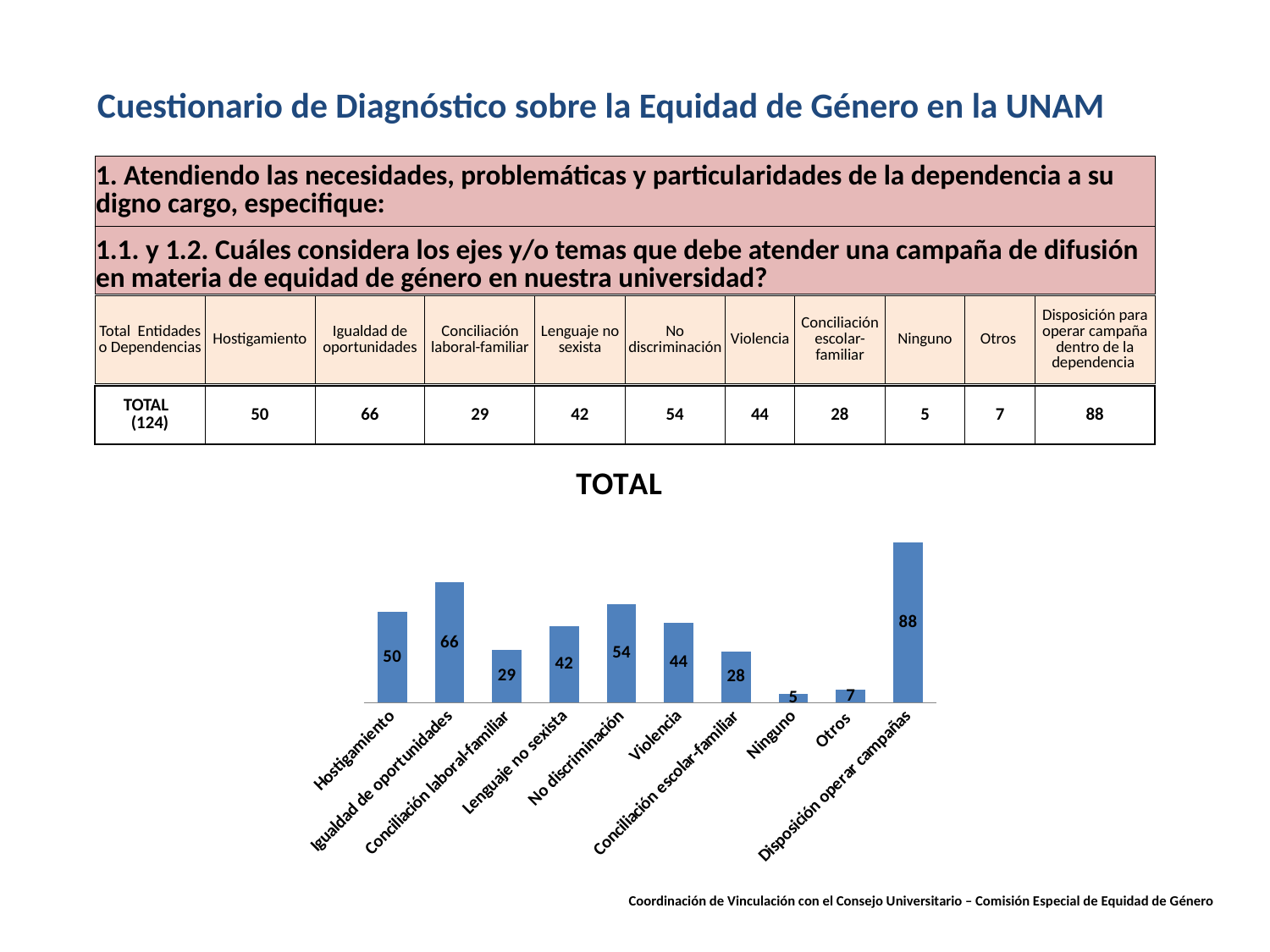
What is the title of the chart on the slide? TOTAL What is the value for Conciliación escolar-familiar in the TOTAL chart? 28 What is the value for Hostigamiento in the TOTAL chart? 50 How many categories are shown in the TOTAL chart? 10 Which category has the highest value in the TOTAL chart? Disposición operar campañas What is the difference between the values for Disposición operar campañas and Igualdad de oportunidades in the TOTAL chart? 22 What is the value for Igualdad de oportunidades in the TOTAL chart? 66 Which is larger in the TOTAL chart, Lenguaje no sexista or Conciliación laboral-familiar? Lenguaje no sexista What kind of chart is the TOTAL chart? Bar chart Which category has the lowest value in the TOTAL chart? Ninguno What is the difference between the values for No discriminación and Violencia in the TOTAL chart? 10 What is the value for Otros in the TOTAL chart? 7